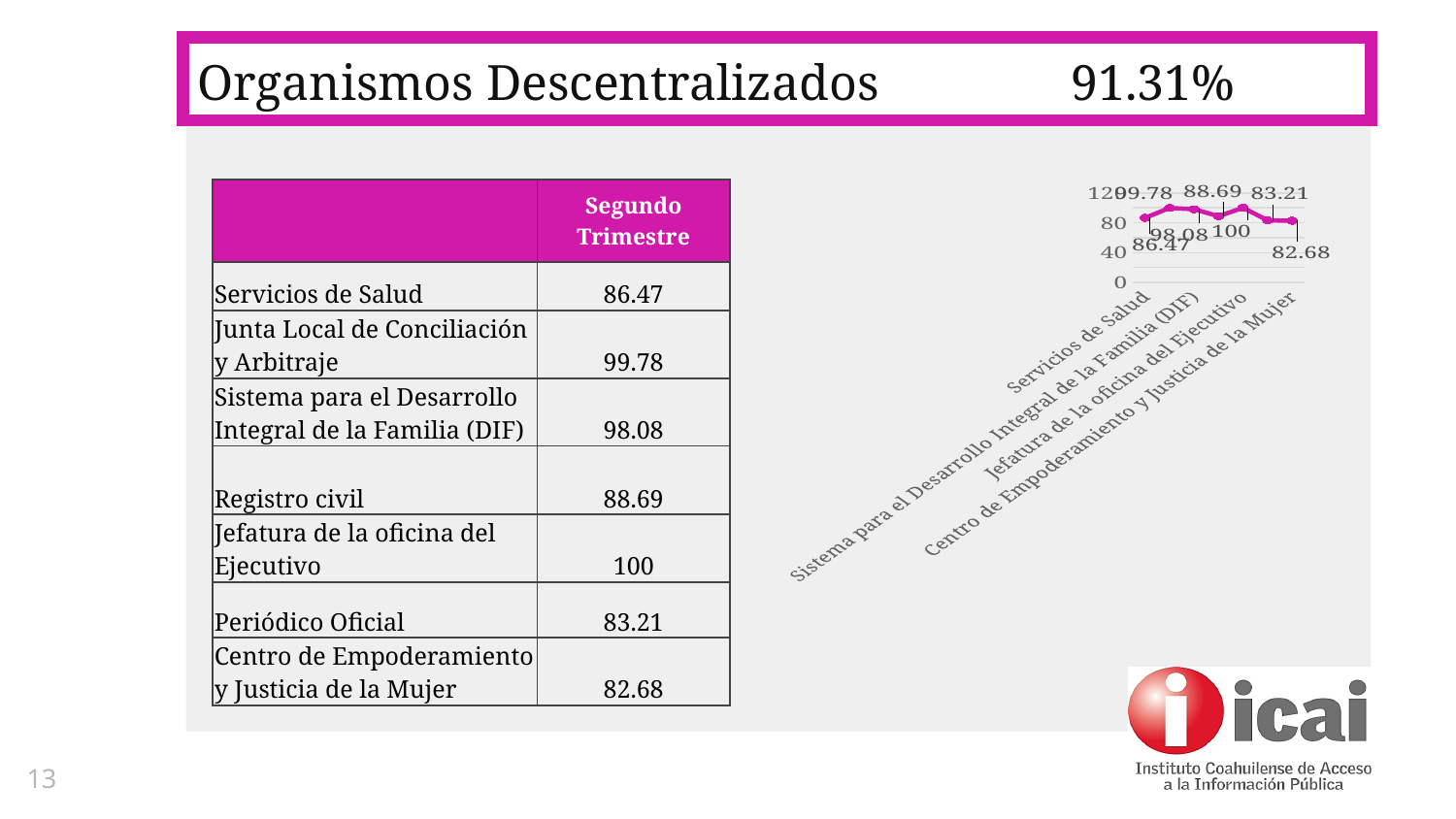
What is the value for Servicios de Salud in the chart? 86.47 What is the value for Sistema para el Desarrollo Integral de la Familia (DIF) in the chart? 98.08 What is the highest tick value shown on the chart's vertical axis? 120 What is the value for Centro de Empoderamiento y Justicia de la Mujer in the chart? 82.68 Which category has the lowest value in the chart? Centro de Empoderamiento y Justicia de la Mujer What kind of chart is shown on the slide? line chart Is the value for Servicios de Salud greater or less than 80? greater What is the difference between the values for Jefatura de la oficina del Ejecutivo and Servicios de Salud? 13.53 What is the value for Jefatura de la oficina del Ejecutivo in the chart? 100 Which is larger, the value for Registro civil or the value for Periódico Oficial? Registro civil How many data points are plotted in the line chart? 7 Which category has the highest value in the chart? Jefatura de la oficina del Ejecutivo